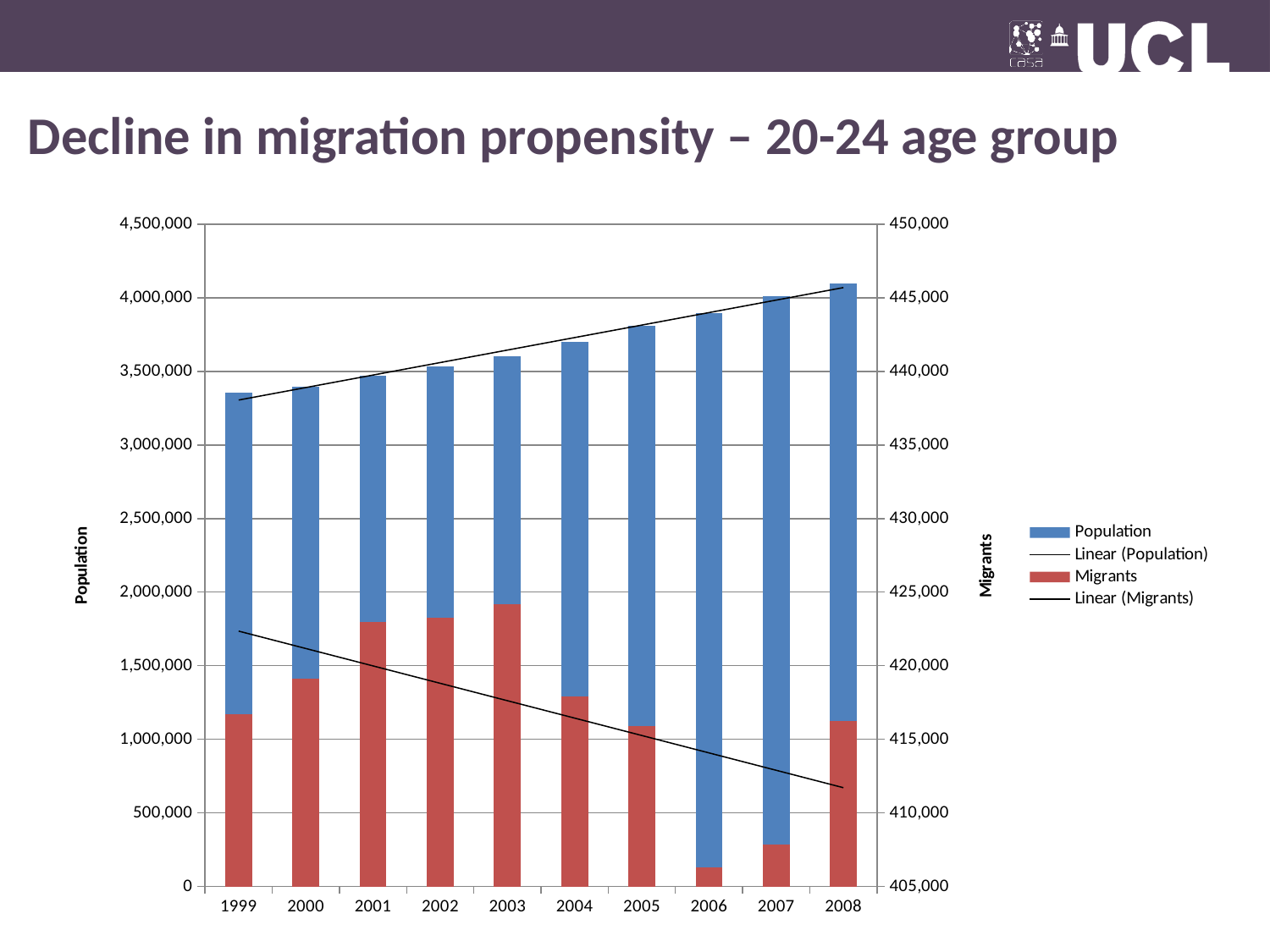
Is the Migrants value for 2006 greater or less than 410,000? less What kind of chart is shown on the slide? bar chart Which year has the lowest Migrants value? 2006 What is the title of the slide containing the chart? Decline in migration propensity – 20-24 age group Which year has the highest Population value? 2008 Which year has the highest Migrants value? 2003 How many entries does the chart's legend list? 4 How many years are shown on the x axis of the chart? 10 Do the Population values rise or fall from 1999 to 2008? rise Is the Population value for 1999 greater or less than 3,500,000? less Is the Population value for 2008 greater or less than 4,000,000? greater Which year has the lowest Population value? 1999